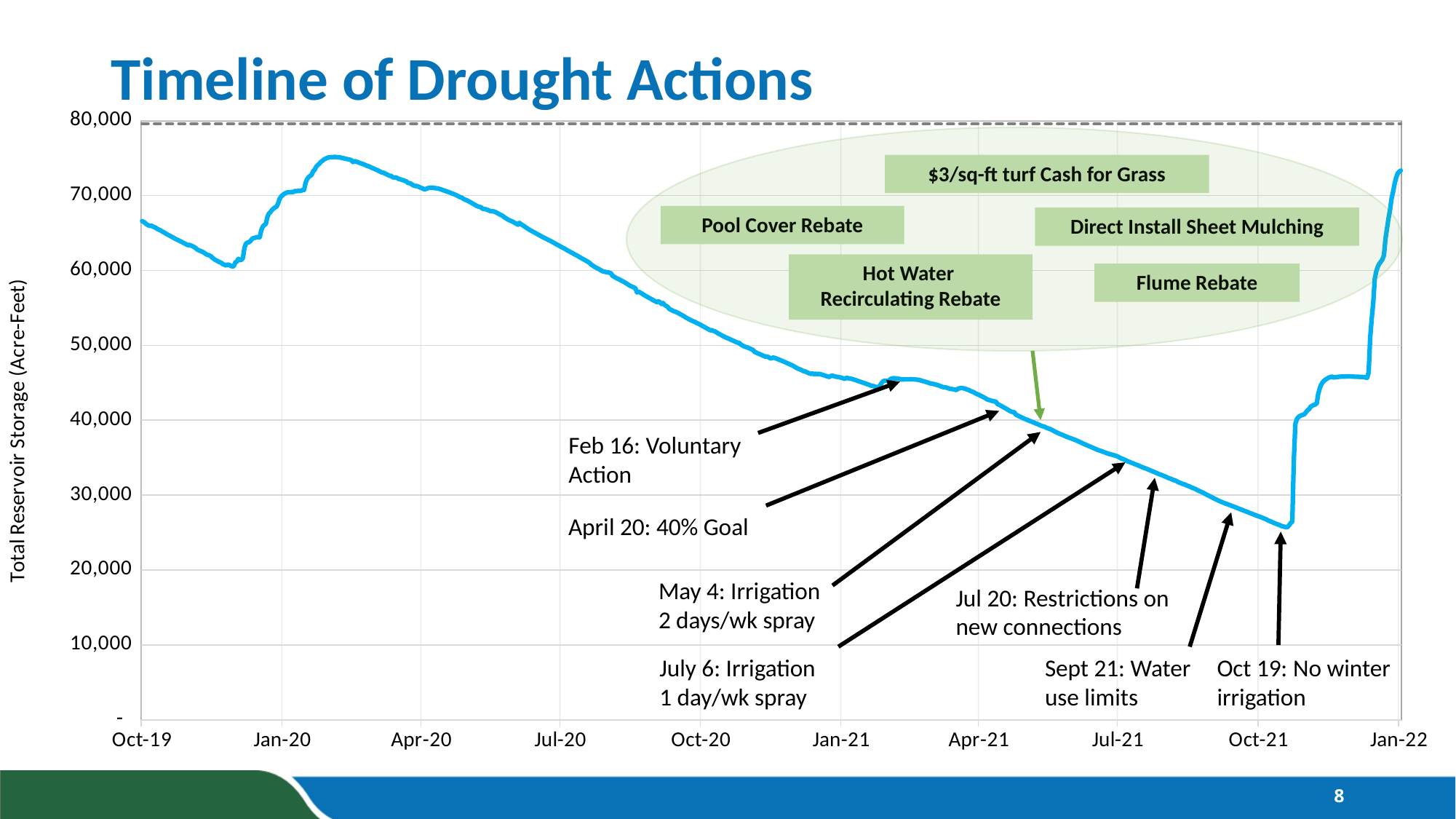
Does the reservoir storage rise or fall between Apr-20 and Oct-21? fall Is the reservoir storage value at Oct-21 greater or less than 30,000? less What is the title of the slide's chart? Timeline of Drought Actions Does the reservoir storage rise or fall between Oct-21 and Jan-22? rise Is the reservoir storage value at Jan-21 greater or less than 50,000? less Is the reservoir storage value at Oct-19 greater or less than 60,000? greater What kind of chart is shown on the slide? line chart What is the label on the vertical axis of the chart? Total Reservoir Storage (Acre-Feet) How many date labels are shown on the x axis of the chart? 10 Which is larger, the reservoir storage at Oct-19 or at Oct-21? Oct-19